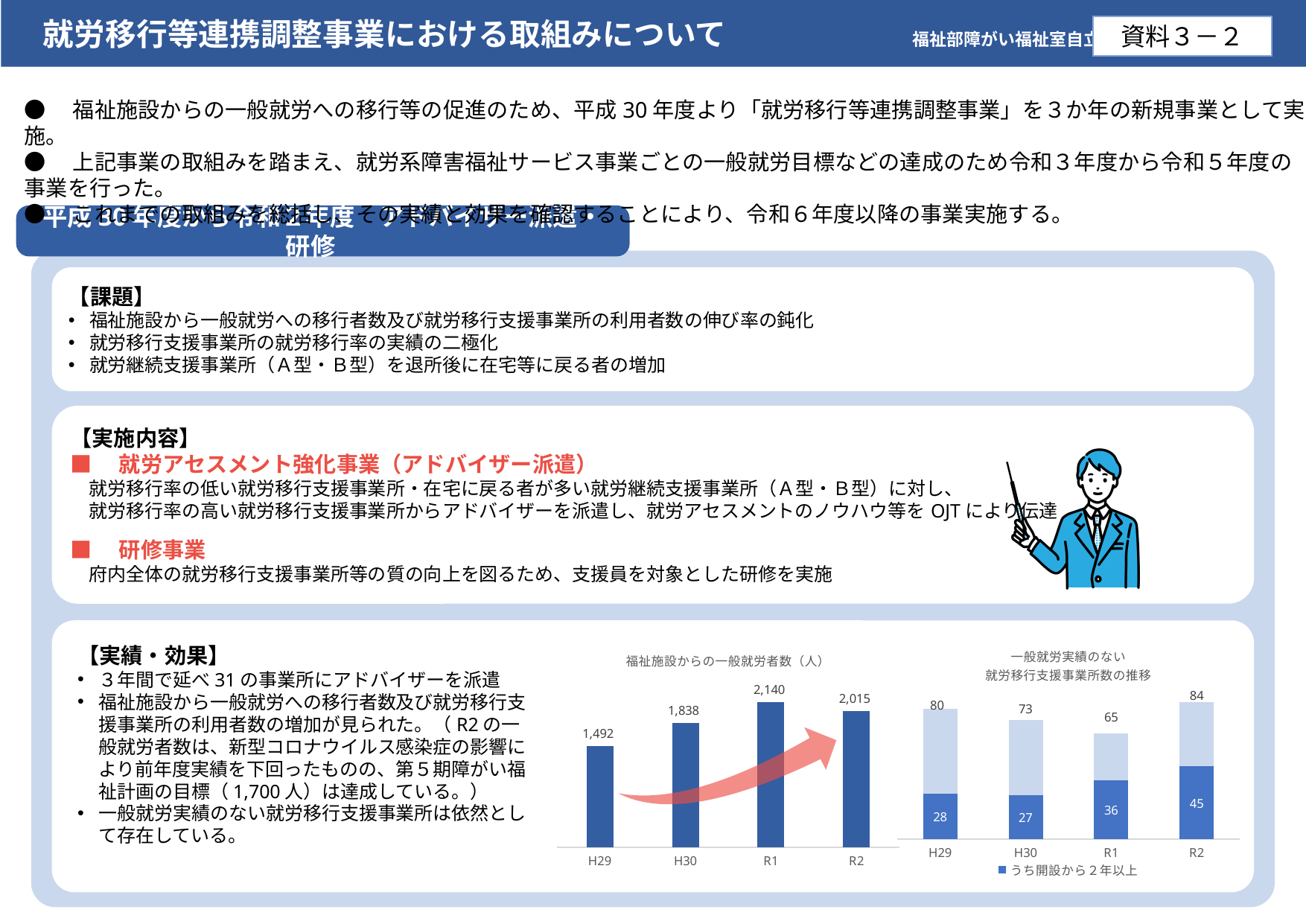
In the chart titled 福祉施設からの一般就労者数（人）, which is larger, the value for R1 or the value for R2? R1 In the chart titled 一般就労実績のない就労移行支援事業所数の推移, which is larger, the うち開設から２年以上 value for H29 or for H30? H29 In the chart titled 一般就労実績のない就労移行支援事業所数の推移, what is the value of the うち開設から２年以上 segment for R1? 36 In the chart titled 福祉施設からの一般就労者数（人）, which year has the highest value? R1 In the chart titled 一般就労実績のない就労移行支援事業所数の推移, what is the total for the R2 bar? 84 In the chart titled 福祉施設からの一般就労者数（人）, which year has the lowest value? H29 In the chart titled 福祉施設からの一般就労者数（人）, what is the value for H30? 1,838 In the chart titled 一般就労実績のない就労移行支援事業所数の推移, what entry does the legend list? うち開設から２年以上 What kind of chart is the chart titled 福祉施設からの一般就労者数（人）? Bar chart In the chart titled 福祉施設からの一般就労者数（人）, what is the difference between the R1 and H30 values? 302 In the chart titled 福祉施設からの一般就労者数（人）, how many years are plotted? 4 In the chart titled 一般就労実績のない就労移行支援事業所数の推移, which year has the lowest total? R1